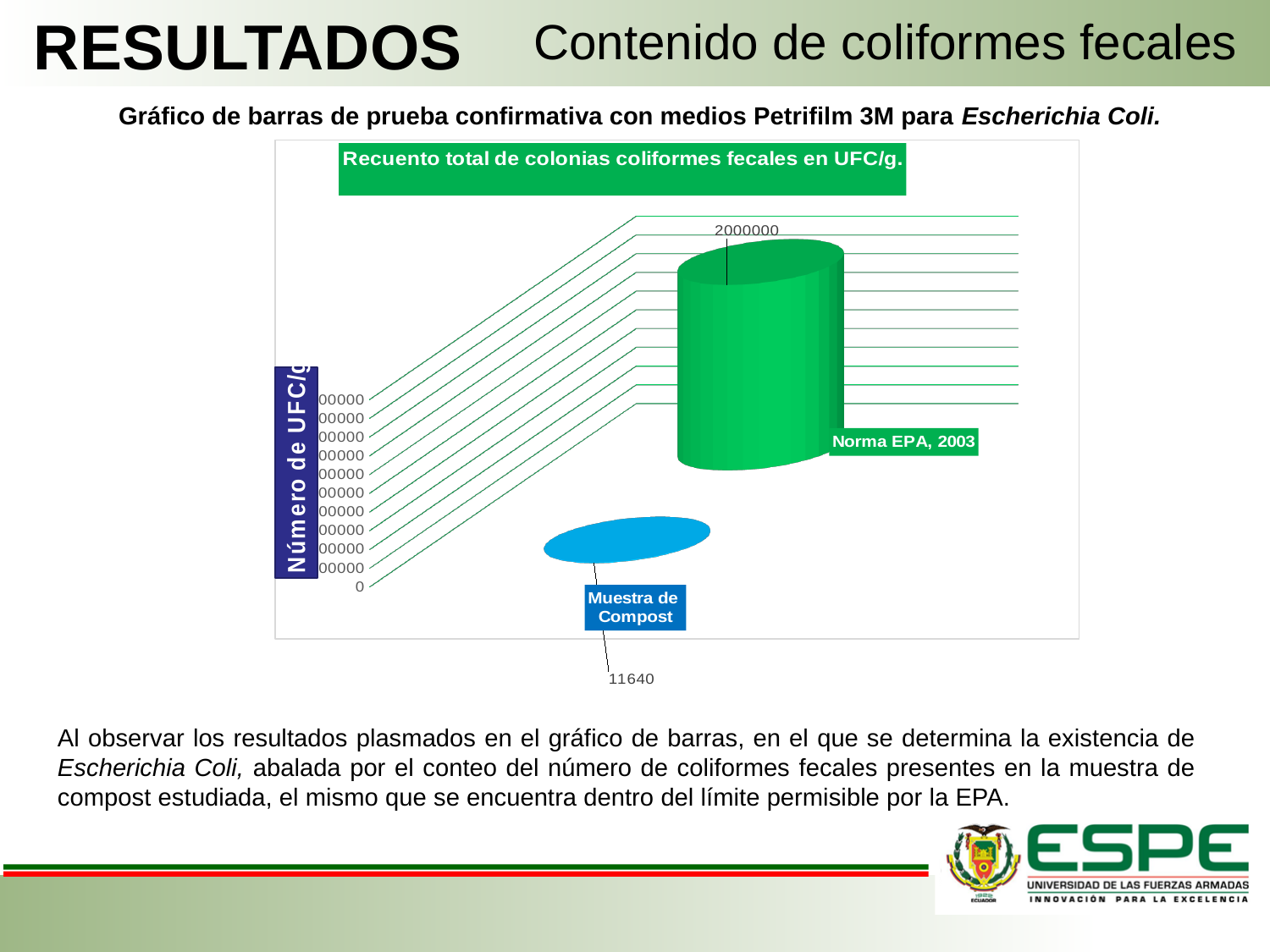
What is the label of the vertical axis of the chart? Número de UFC/g What is the title of the chart? Recuento total de colonias coliformes fecales en UFC/g. How many categories are plotted in the chart? 2 What is the difference between the value for Norma EPA, 2003 and the value for Muestra de Compost? 1988360 What is the value for Norma EPA, 2003? 2000000 Which category has the lowest value? Muestra de Compost Which category has the highest value? Norma EPA, 2003 What kind of chart is shown on the slide? Bar chart What is the value for Muestra de Compost? 11640 Which is larger, the value for Muestra de Compost or the value for Norma EPA, 2003? Norma EPA, 2003